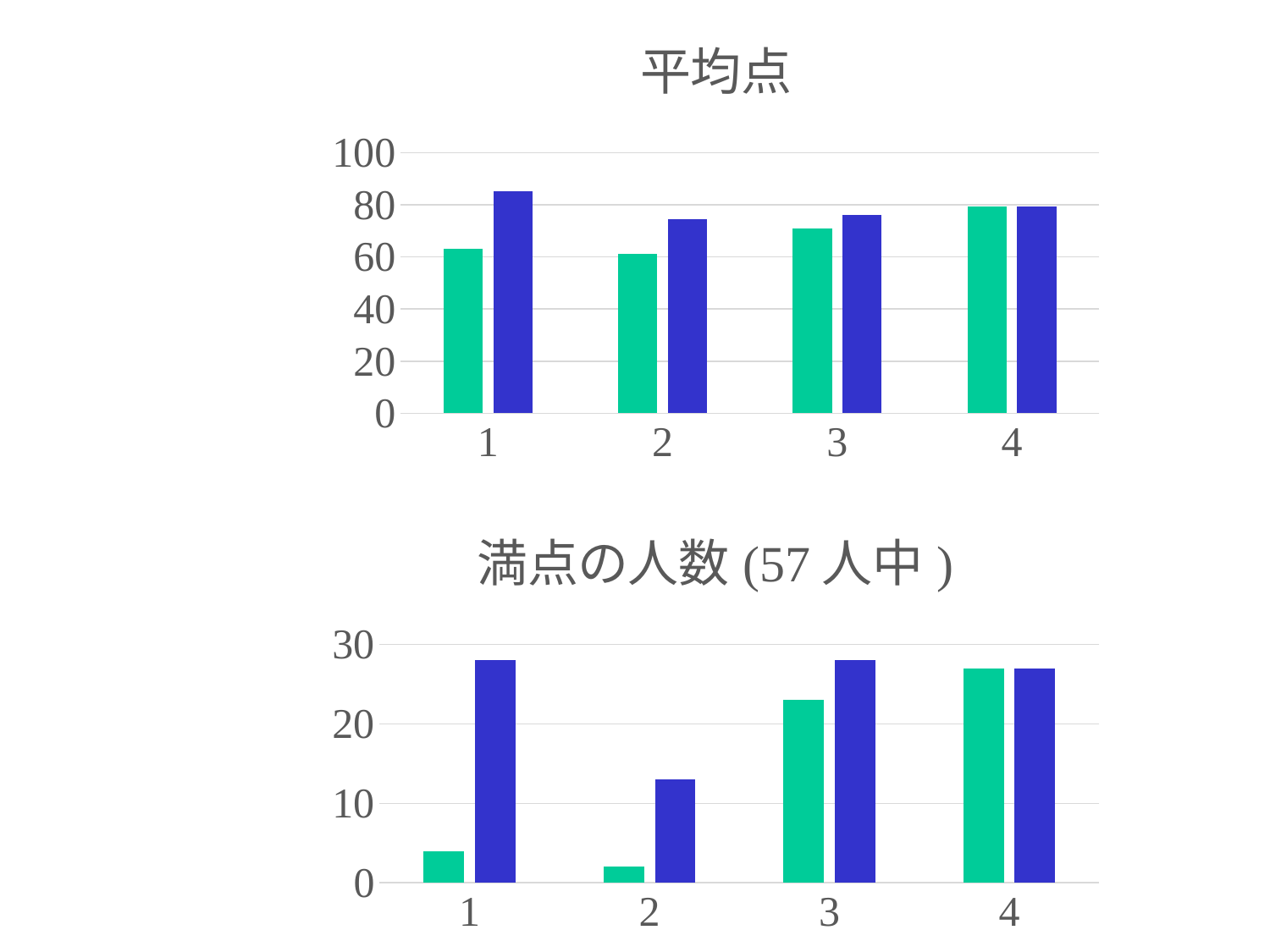
What kind of chart is the top chart titled 平均点? bar chart What is the title of the bottom chart? 満点の人数 (57 人中 ) In the bottom chart titled 満点の人数 (57 人中), is the green bar for category 1 greater or less than 10? less In the top chart titled 平均点, for category 1, is the green bar or the blue bar larger? blue In the top chart titled 平均点, which category has the highest blue bar? 1 In the bottom chart titled 満点の人数 (57 人中), is the blue bar for category 2 greater or less than 10? greater In the bottom chart titled 満点の人数 (57 人中), for category 2, is the green bar or the blue bar larger? blue In the top chart titled 平均点, which category has the highest green bar? 4 How many categories are shown on the x axis of the bottom chart titled 満点の人数 (57 人中)? 4 In the top chart titled 平均点, is the blue bar for category 1 greater or less than 80? greater In the bottom chart titled 満点の人数 (57 人中), which category has the lowest green bar? 2